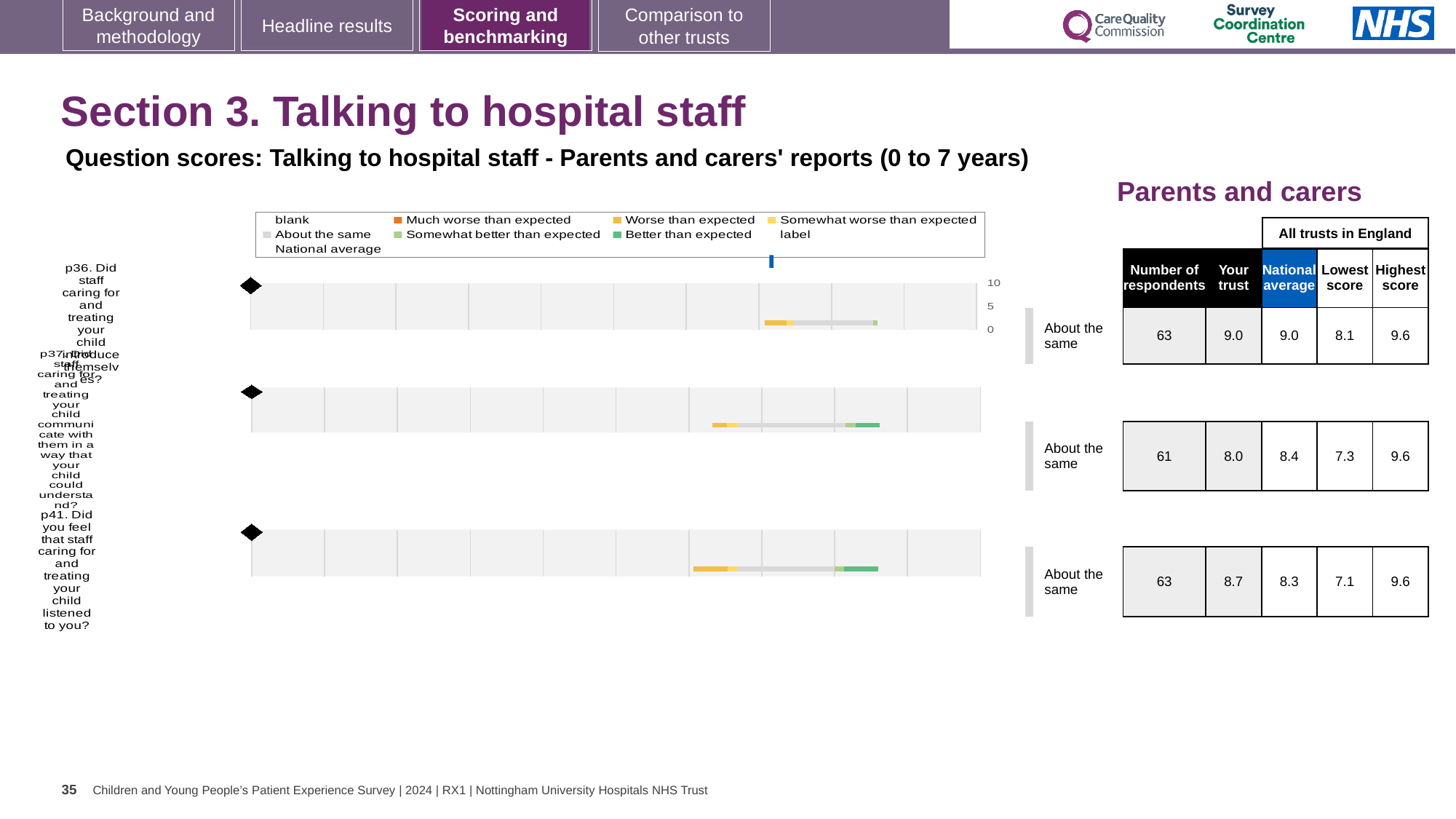
For p37, what is the difference between the Highest score and the Lowest score across all trusts in England? 2.3 Which question has the highest 'Your trust' score? p36 What kind of chart is used to show the question scores on this slide? Bar chart What is the 'Your trust' score for p36 (Did staff caring for and treating your child introduce themselves)? 9.0 For p41 (Did you feel that staff listened to you), which is larger: the 'Your trust' score or the National average? Your trust What benchmark category is shown next to each of the three charts? About the same What is the National average score for p37 (Did staff communicate with your child in a way they could understand)? 8.4 What colour does the legend use for 'Better than expected'? Green Which question has the lowest 'Your trust' score? p37 How many questions (p36, p37, p41) have a chart on this slide? 3 How many respondents answered p41? 63